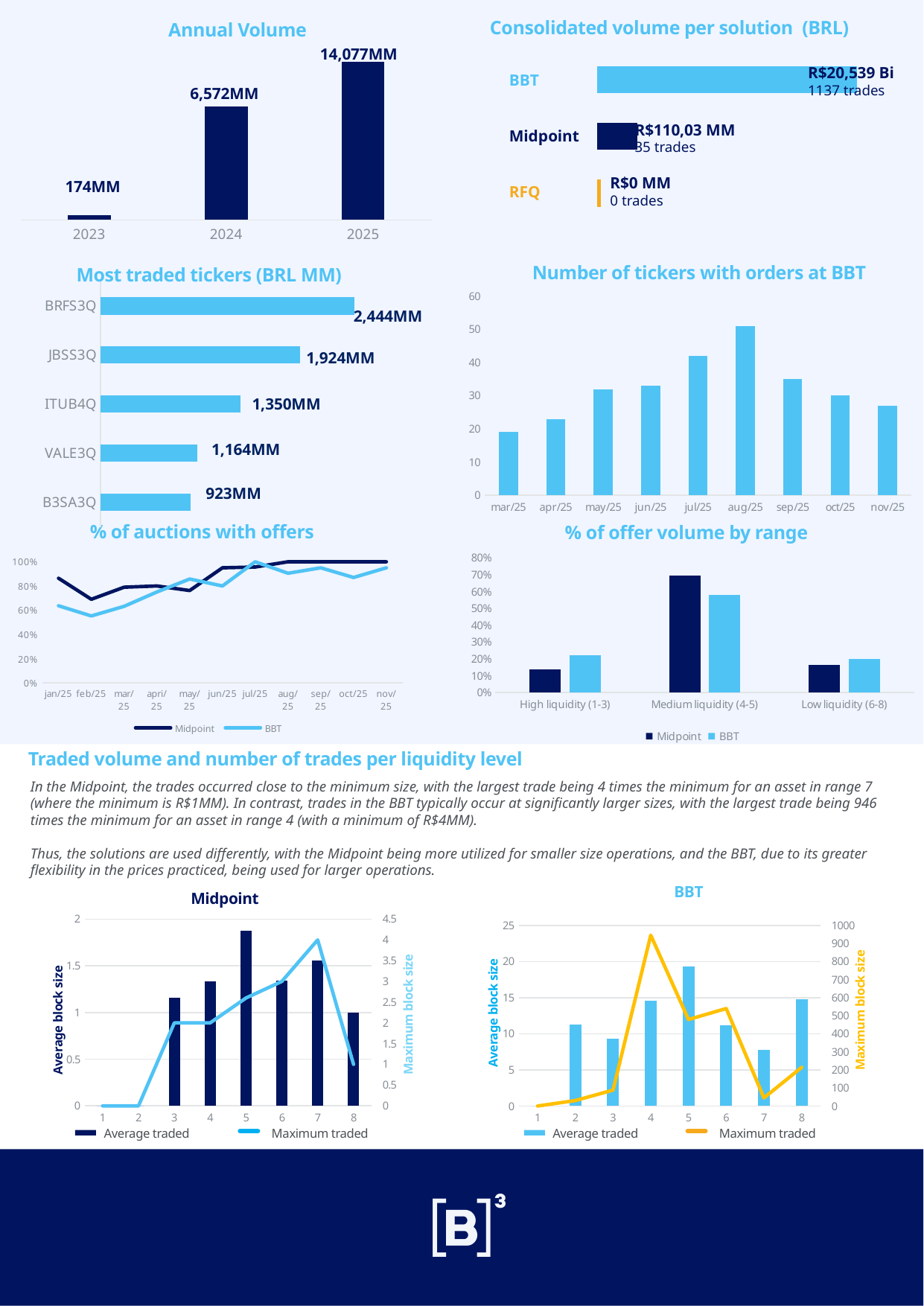
In the % of offer volume by range chart, which liquidity range has the highest Midpoint value? Medium liquidity (4-5) In the Most traded tickers (BRL MM) chart, which ticker has the highest value? BRFS3Q In the Most traded tickers (BRL MM) chart, what is the difference between JBSS3Q and ITUB4Q? 574MM In the Consolidated volume per solution (BRL) chart, what is the volume for Midpoint? R$110,03 MM In the Annual Volume chart, what is the value for 2025? 14,077MM In the Number of tickers with orders at BBT chart, which month has the highest value? aug/25 In the Consolidated volume per solution (BRL) chart, how many trades are shown for BBT? 1137 trades In the % of auctions with offers chart, how many series does the legend list? 2 In the Number of tickers with orders at BBT chart, is the value for jul/25 greater or less than 40? greater In the Annual Volume chart, what is the difference between the 2024 and 2023 values? 6,398MM In the Number of tickers with orders at BBT chart, how many months are shown on the x axis? 9 In the Most traded tickers (BRL MM) chart, what is the value for VALE3Q? 1,164MM